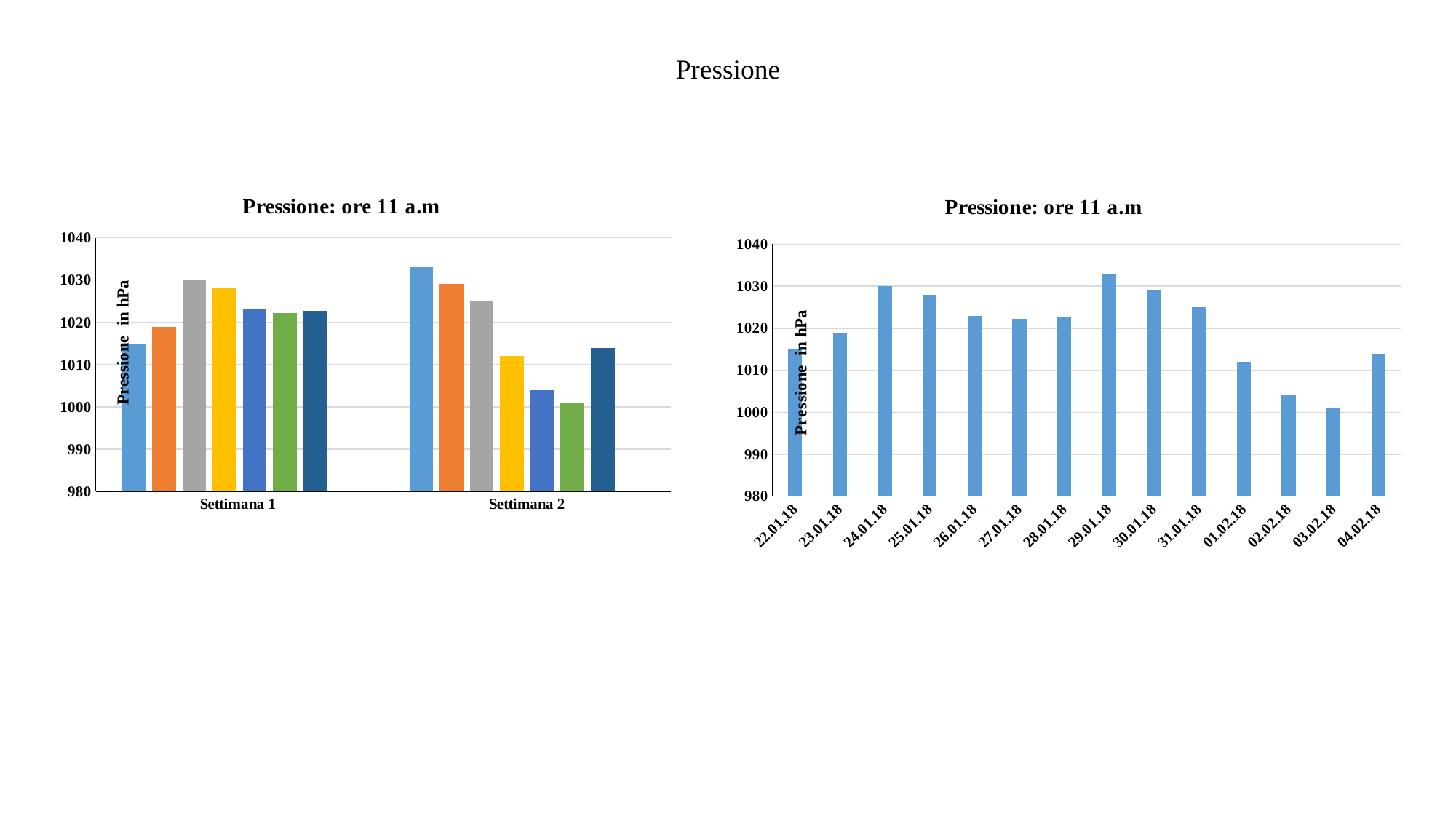
What kind of chart is the right chart on the slide? bar chart In the right chart, is the value for 24.01.18 greater or less than 1020? greater In the right chart, how many dates are shown on the x axis? 14 In the right chart, is the value for 02.02.18 greater or less than 1010? less In the right chart, which date has the highest pressure? 29.01.18 In the left chart, how many category groups are shown on the x axis? 2 In the right chart, do the values rise or fall from 29.01.18 to 03.02.18? fall In the right chart, which date has the lowest pressure? 03.02.18 In the right chart, is the value for 22.01.18 greater or less than 1020? less In the right chart, which is larger, the value for 25.01.18 or the value for 26.01.18? 25.01.18 What is the y-axis title of the left chart? Pressione in hPa In the left chart, how many bars are in the Settimana 1 group? 7